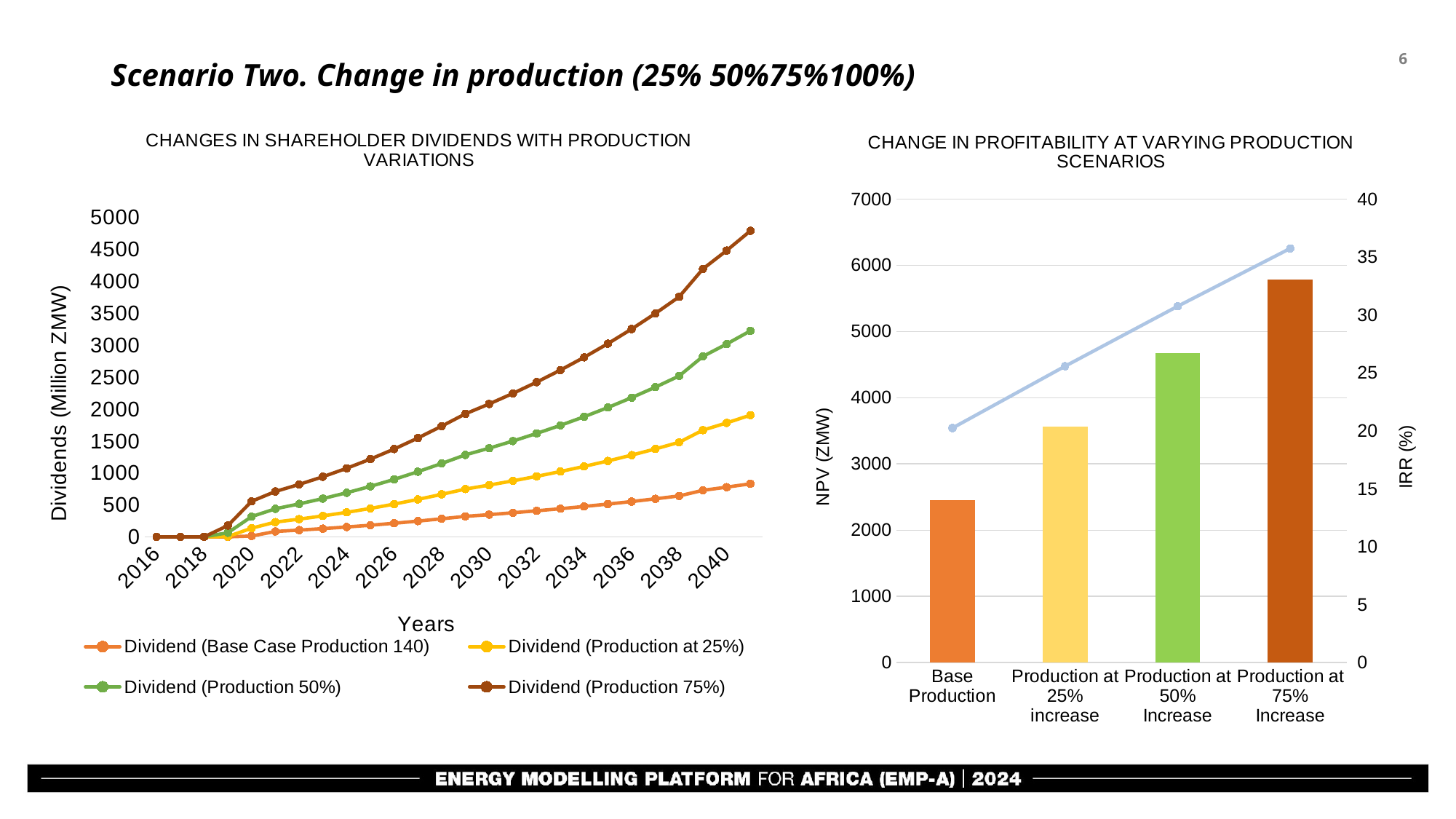
On the left chart, do the dividend values rise or fall from 2020 to 2040? Rise On the right chart, is the NPV for Base Production greater or less than 3000? less On the left chart, is the value for Dividend (Production 75%) in 2038 greater or less than 3500? greater What kind of chart is the left chart, 'Changes in Shareholder Dividends with Production Variations'? Line chart On the left chart, 'Changes in Shareholder Dividends with Production Variations', how many series does the legend list? 4 On the right chart, 'Change in Profitability at Varying Production Scenarios', which scenario has the highest NPV bar? Production at 75% Increase On the right chart, 'Change in Profitability at Varying Production Scenarios', which scenario has the lowest NPV bar? Base Production On the left chart, which series has the lowest dividend in 2040? Dividend (Base Case Production 140) On the left chart, what is the label of the y axis? Dividends (Million ZMW) On the left chart, is the value for Dividend (Base Case Production 140) in 2040 greater or less than 1000? less On the left chart, which series has the highest dividend in 2040? Dividend (Production 75%) On the right chart, how many production scenarios are shown on the x axis? 4